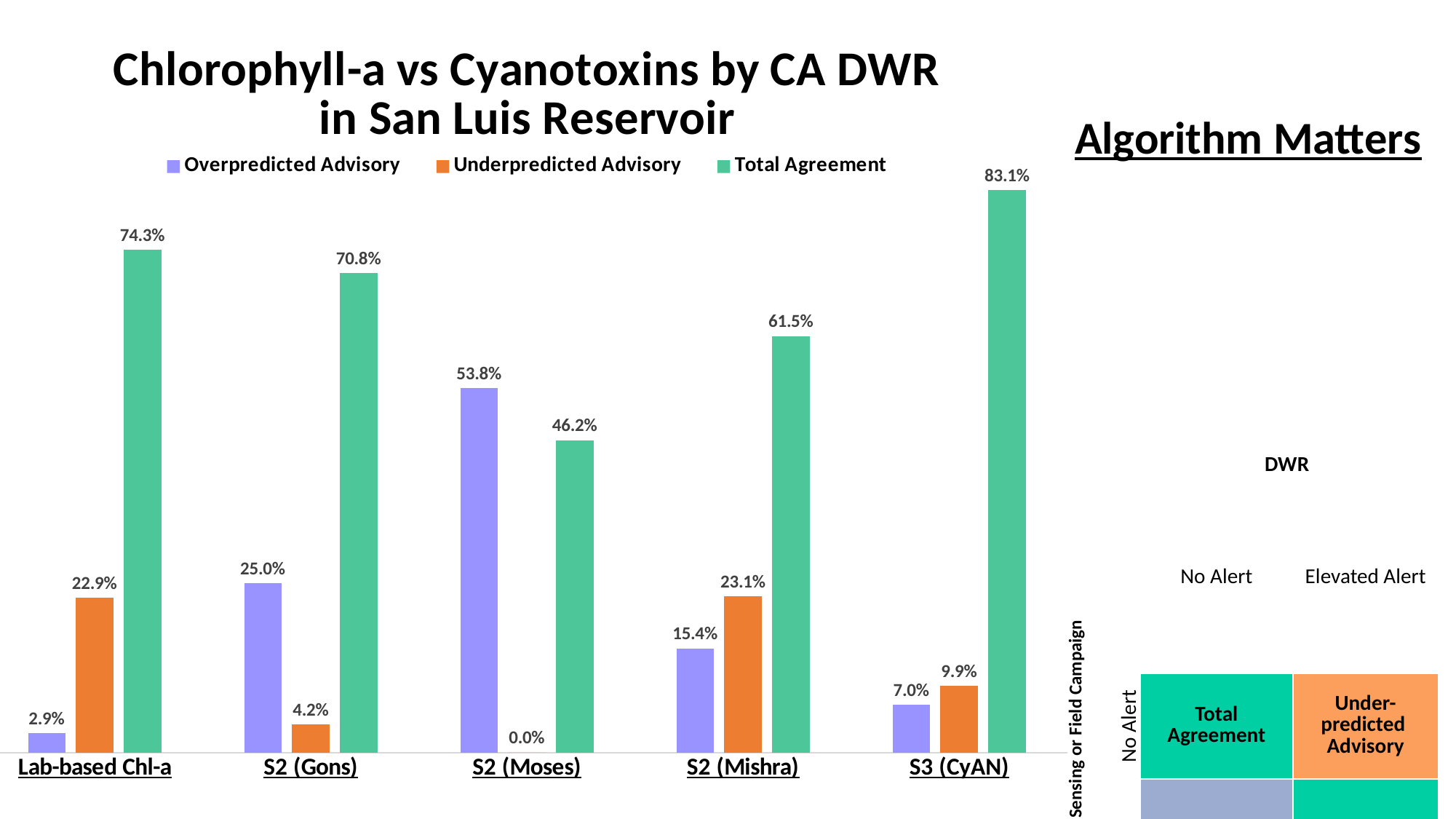
What is the difference between the Total Agreement values for Lab-based Chl-a and S2 (Gons)? 3.5% Which category has the lowest Underpredicted Advisory value? S2 (Moses) What is the Overpredicted Advisory value for S2 (Moses)? 53.8% Which colour represents the Total Agreement series in the chart? Green What is the Total Agreement value for S3 (CyAN)? 83.1% What kind of chart is shown on the slide? Bar chart Which is larger: the Overpredicted Advisory value for S2 (Gons) or for S2 (Mishra)? S2 (Gons) What is the title of the chart? Chlorophyll-a vs Cyanotoxins by CA DWR in San Luis Reservoir How many categories are shown on the x axis of the chart? 5 How many series does the chart legend list? 3 What is the Underpredicted Advisory value for Lab-based Chl-a? 22.9% Which category has the highest Total Agreement value? S3 (CyAN)